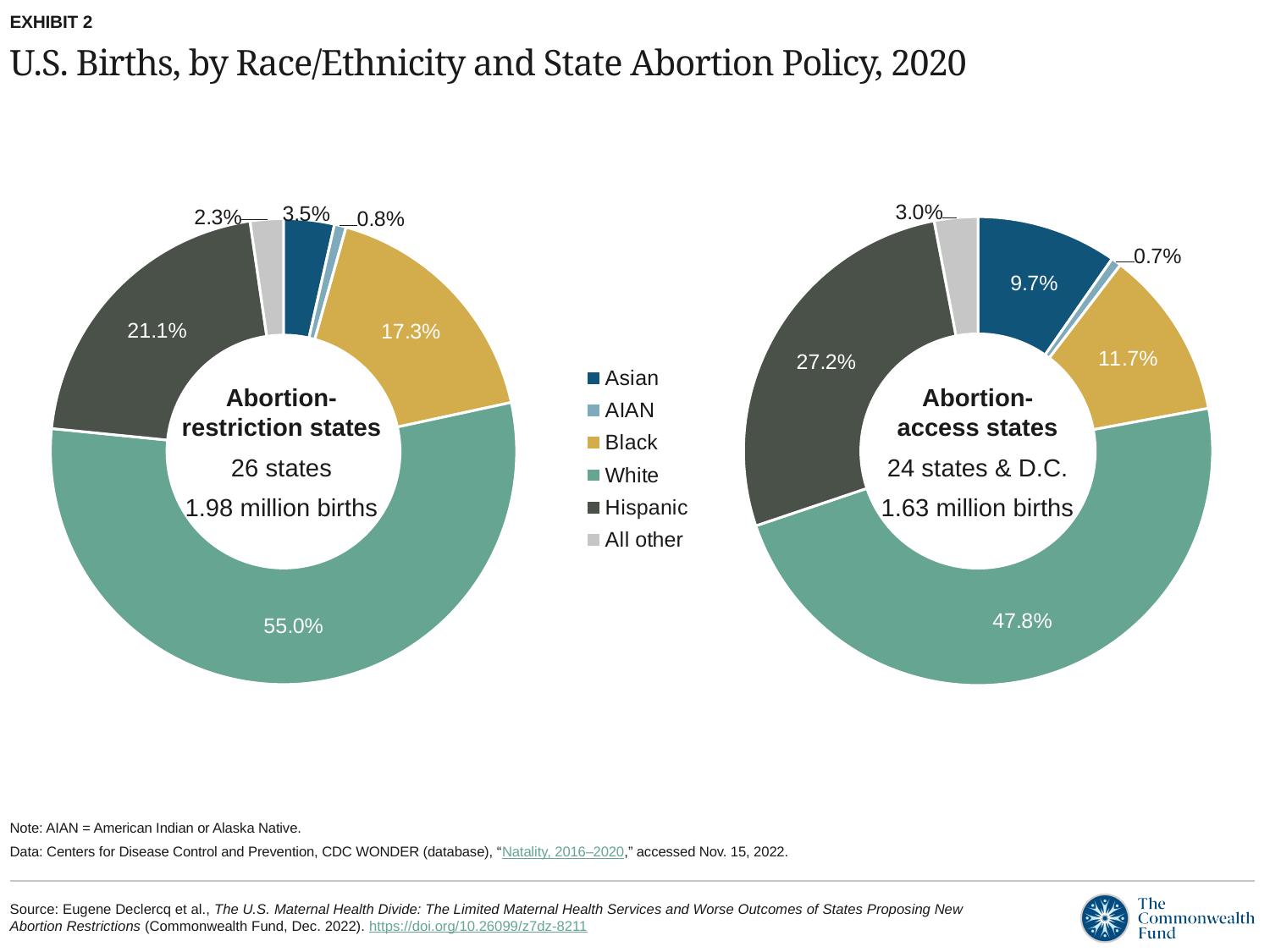
How many race/ethnicity groups does the legend list? 6 In the Abortion-access states chart, what share of births is Asian? 9.7% What is the difference in percentage points between the Hispanic share in Abortion-access states and the Hispanic share in Abortion-restriction states? 6.1 percentage points How many states are included in the Abortion-restriction states chart? 26 states In the Abortion-access states chart, what share of births is Hispanic? 27.2% In the Abortion-restriction states chart, which race/ethnicity group has the largest share of births? White In the Abortion-restriction states chart, what share of births is Black? 17.3% In the Abortion-restriction states chart, what share of births is White? 55.0% Is the Black share of births larger in Abortion-restriction states or Abortion-access states? Abortion-restriction states What type of chart is used on this slide? Donut (pie) chart In the Abortion-access states chart, which race/ethnicity group has the smallest share of births? AIAN How many births are shown for the Abortion-access states chart? 1.63 million births